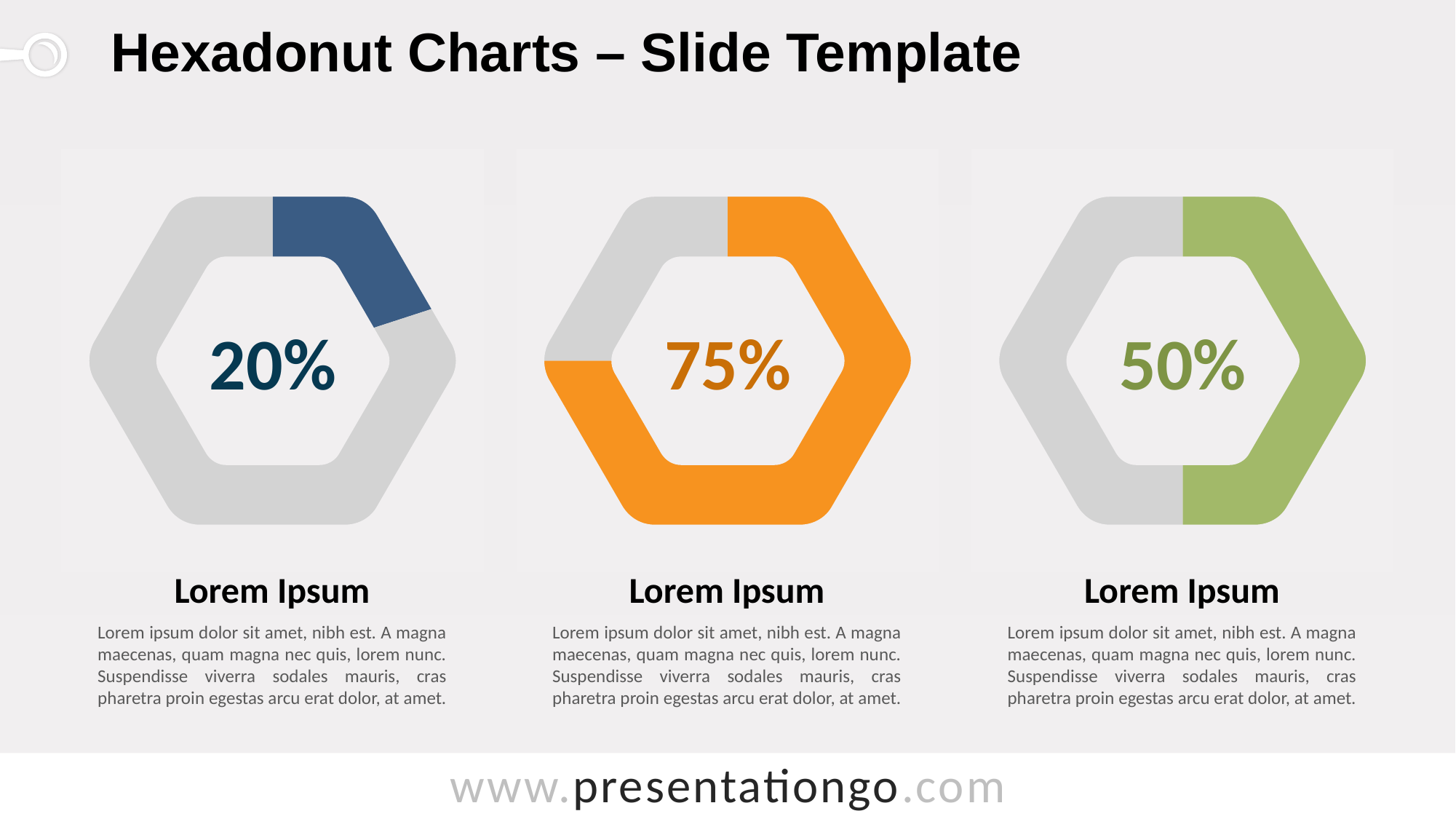
Which shows a larger percentage, the right hexadonut chart or the left hexadonut chart? right What percentage is shown in the middle hexadonut chart? 75% What colour is the filled portion of the middle hexadonut chart? orange How many hexadonut charts are on the slide? 3 What is the difference between the percentage in the middle hexadonut chart and the percentage in the left hexadonut chart? 55% What percentage is shown in the left hexadonut chart? 20% Which of the three hexadonut charts shows the highest percentage: left, middle or right? middle What is the difference between the percentage in the right hexadonut chart and the percentage in the left hexadonut chart? 30% What colour is the filled portion of the right hexadonut chart? green What percentage is shown in the right hexadonut chart? 50% Which of the three hexadonut charts shows the lowest percentage: left, middle or right? left Do the percentages rise or fall from the middle hexadonut chart to the right hexadonut chart? fall